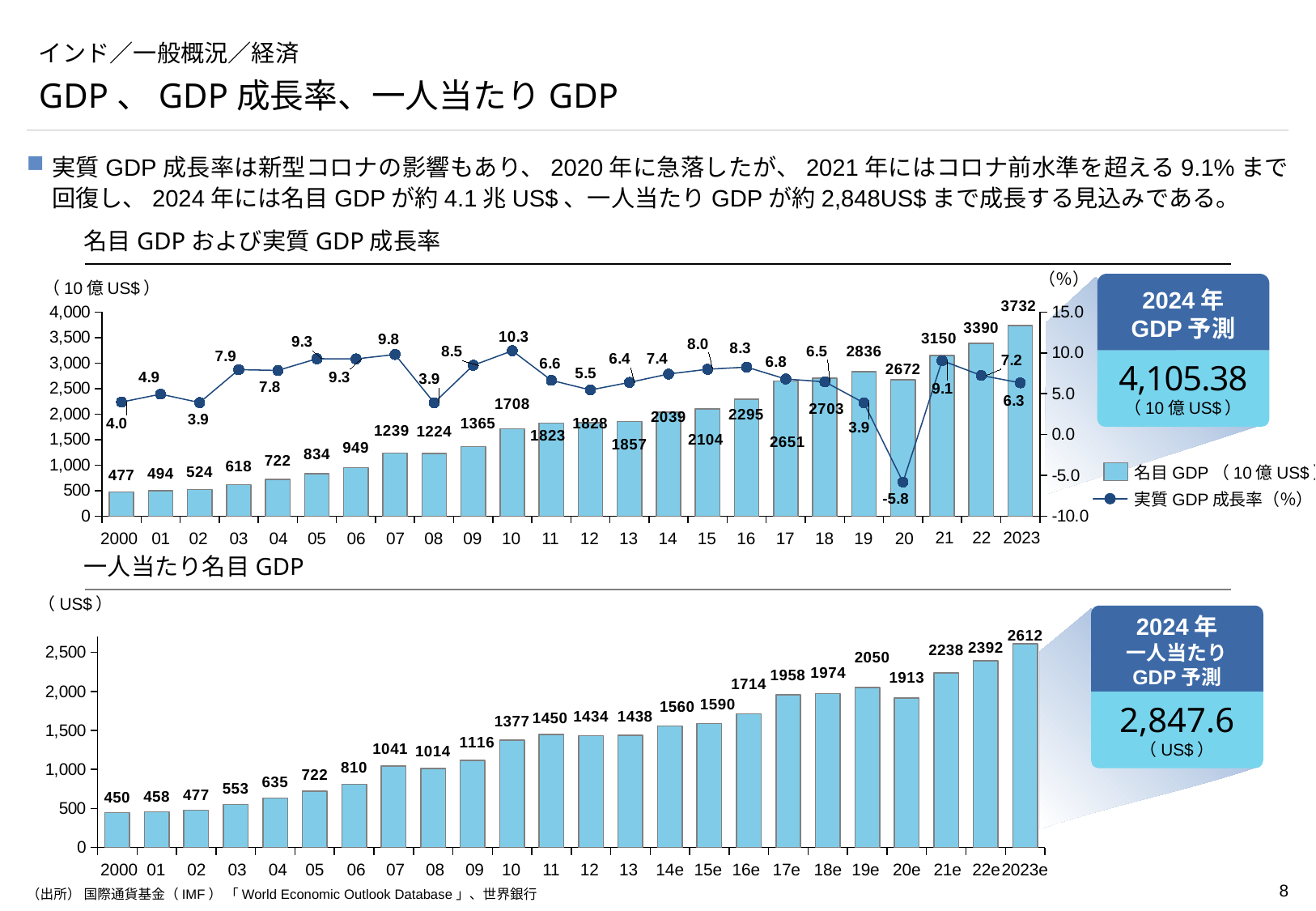
In the top chart (名目GDPおよび実質GDP成長率), what is the nominal GDP value for 2023? 3732 In the bottom chart (一人当たり名目GDP), how many years are plotted? 24 In the top chart (名目GDPおよび実質GDP成長率), how many series does the legend list? 2 In the top chart (名目GDPおよび実質GDP成長率), which year has the lowest real GDP growth rate? 20 In the bottom chart (一人当たり名目GDP), what is the value for 2023e? 2612 What kind of chart is the bottom chart (一人当たり名目GDP)? Bar chart In the bottom chart (一人当たり名目GDP), what is the difference between the values for 2023e and 22e? 220 In the bottom chart (一人当たり名目GDP), which year has the lowest value? 2000 In the top chart (名目GDPおよび実質GDP成長率), what is the difference in nominal GDP between 2023 and 22? 342 In the bottom chart (一人当たり名目GDP), which is larger, the value for 19e or the value for 20e? 19e In the top chart (名目GDPおよび実質GDP成長率), which year has the highest real GDP growth rate? 10 In the top chart (名目GDPおよび実質GDP成長率), what is the real GDP growth rate for 2020? -5.8